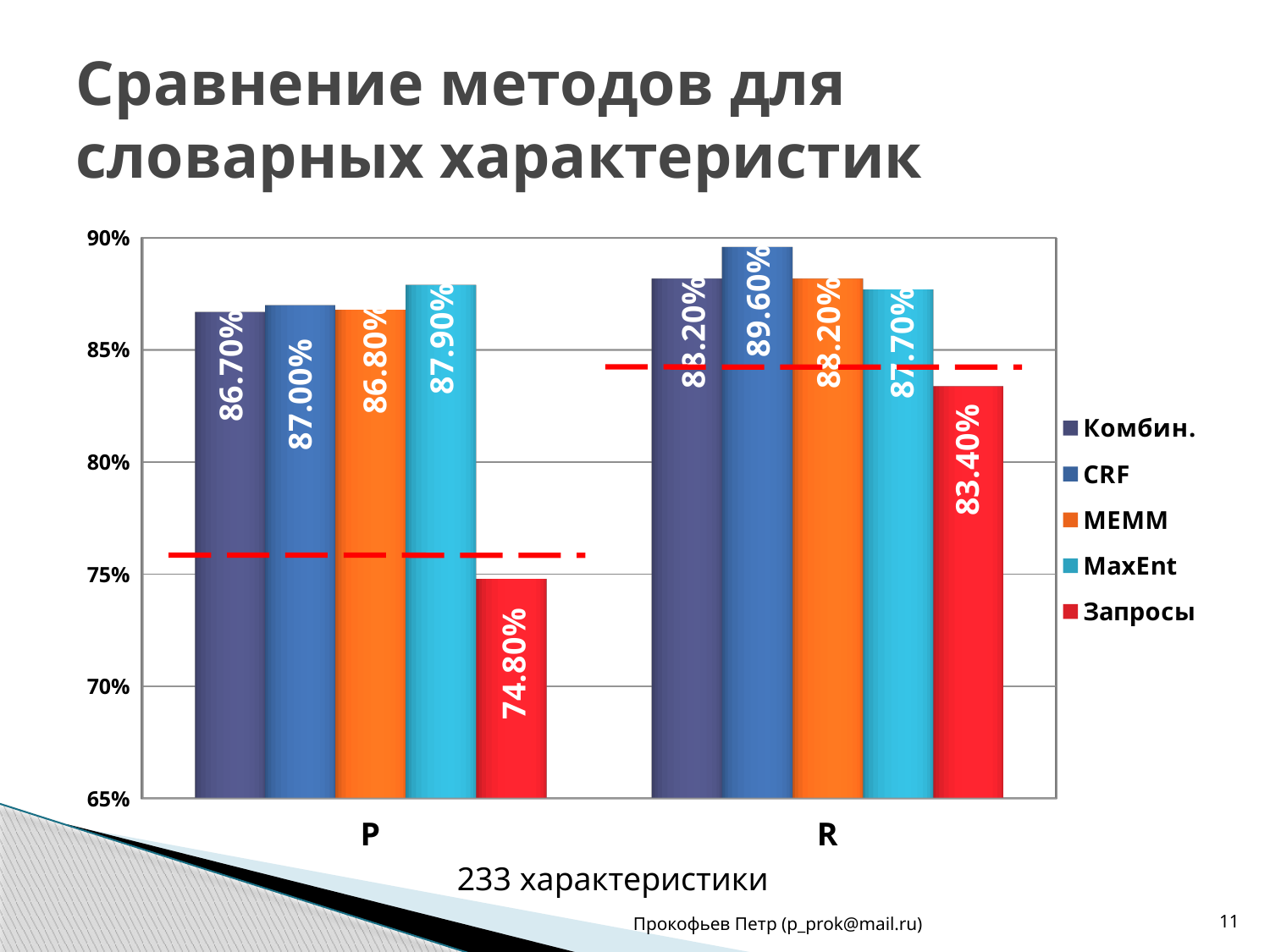
What is the label shown below the x axis categories? 233 характеристики How many series does the legend list? 5 Which series has the lowest value in category P? Запросы What is the difference between the CRF value and the Запросы value in category R? 6.20% What kind of chart is shown on the slide? Bar chart How many categories are shown on the x axis? 2 Which is larger: the MaxEnt value in category P or the MaxEnt value in category R? MaxEnt in P What is the value for MaxEnt in category P? 87.90% What is the value for CRF in category R? 89.60% Which series has the highest value in category R? CRF What is the value for Запросы in category P? 74.80% What is the value for Комбин. in category R? 88.20%